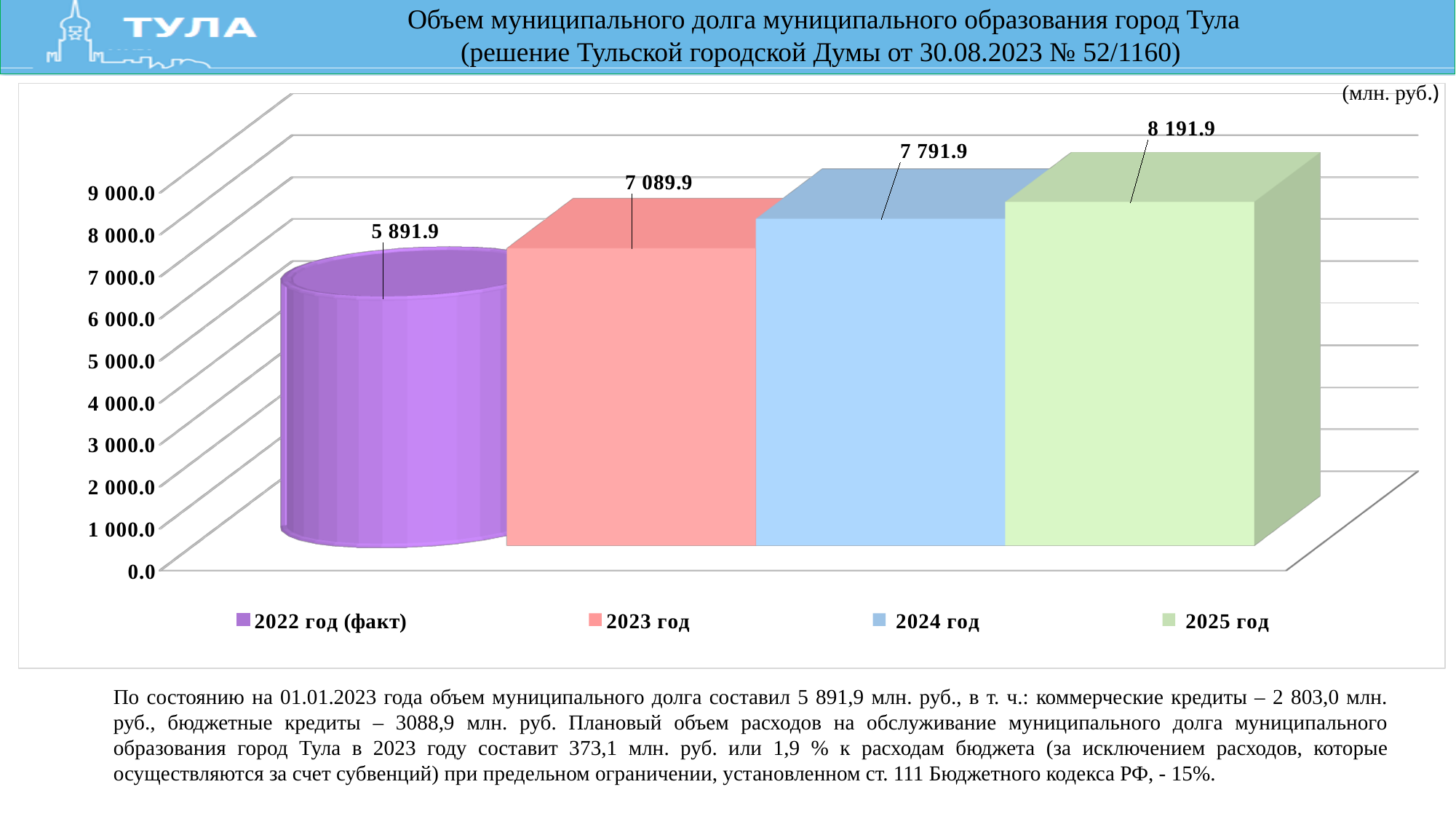
What is the difference between the values for 2023 год and 2022 год (факт)? 1 198.0 What is the value for 2022 год (факт)? 5 891.9 Which is larger, the value for 2024 год or the value for 2023 год? 2024 год How many bars are plotted on the chart? 4 Do the values rise or fall from 2022 год (факт) to 2025 год? Rise What is the difference between the values for 2025 год and 2024 год? 400.0 Which year has the lowest value? 2022 год (факт) Which year has the highest value? 2025 год What is the value for 2023 год? 7 089.9 What is the value for 2024 год? 7 791.9 What kind of chart is shown on the slide? Bar chart What is the value for 2025 год? 8 191.9